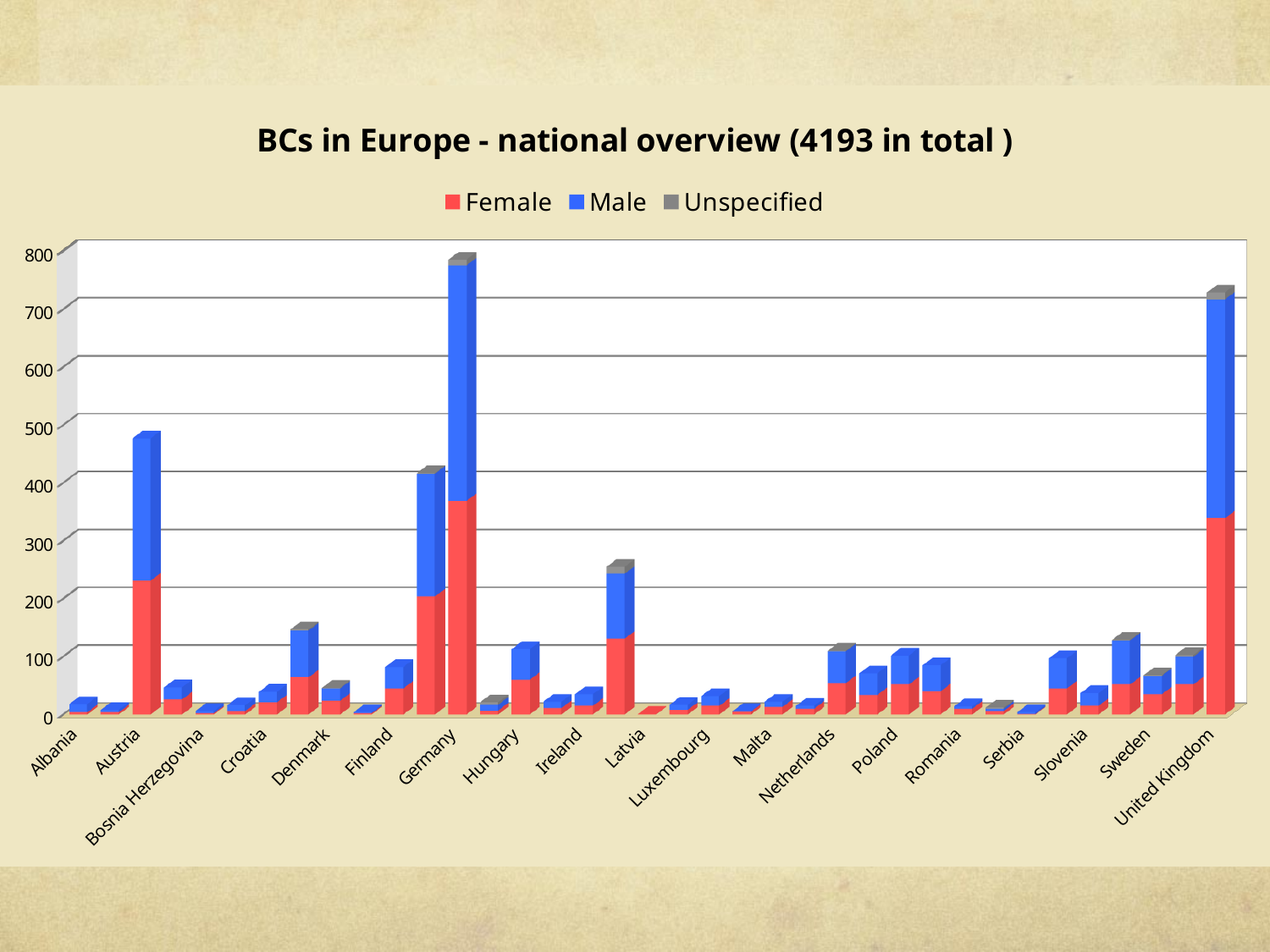
Is the total value for Serbia greater or less than 100? less Which has a larger total, Austria or Netherlands? Austria Is the total value for United Kingdom greater or less than 600? greater What is the title of the chart? BCs in Europe - national overview (4193 in total ) Which country has the tallest bar in the chart? Germany Which colour represents the Female series in the legend? red Is the total value for Latvia greater or less than 100? less How many series does the legend list? 3 Which has a larger total, Germany or Austria? Germany What kind of chart is shown on the slide? stacked bar chart